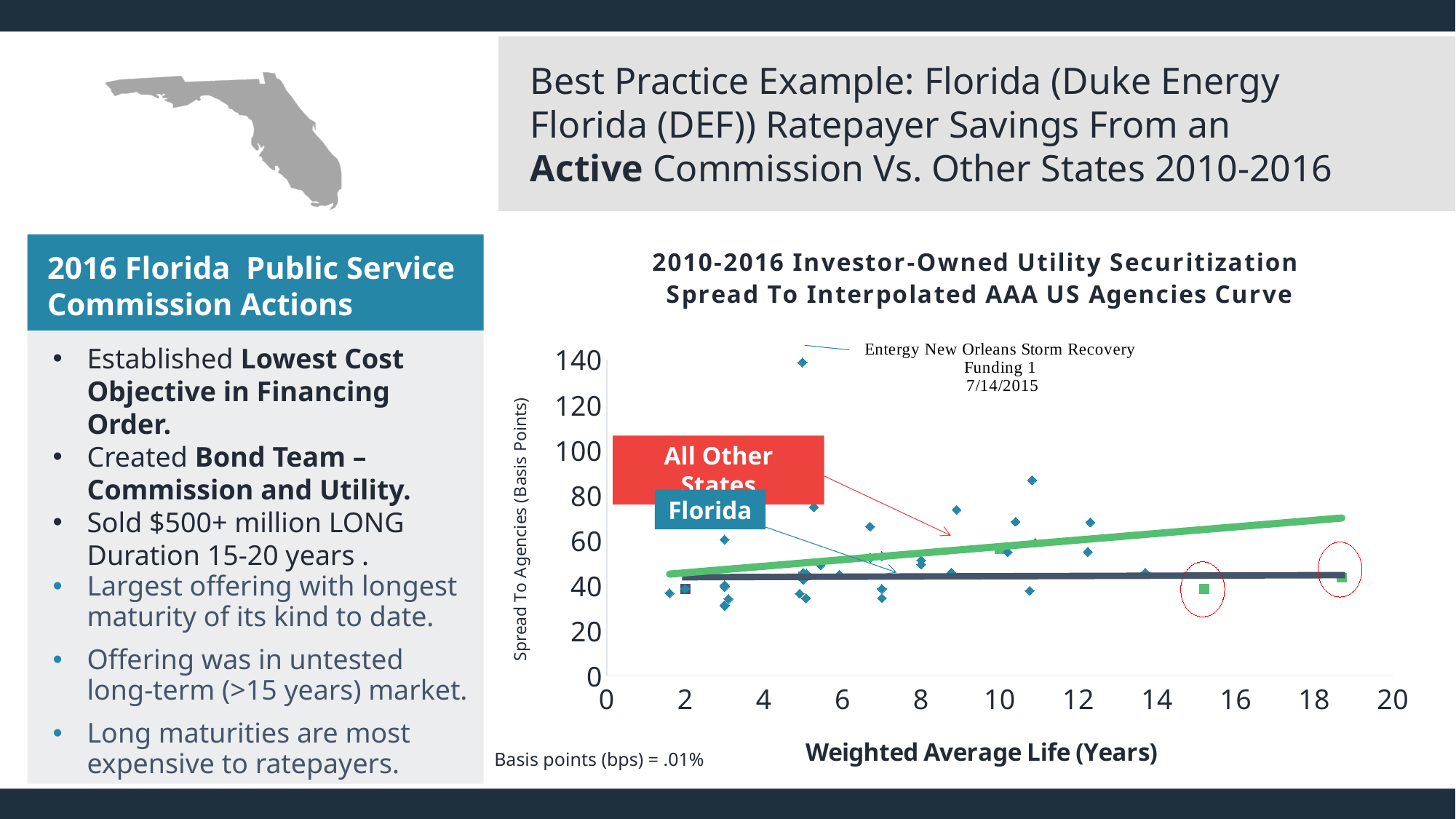
Is the spread for the Entergy New Orleans Storm Recovery Funding 1 point greater or less than 100? greater Is the spread for the Entergy New Orleans Storm Recovery Funding 1 point greater or less than 120? greater Is the spread for the Florida point at about 15 years weighted average life greater or less than 60? less Which labeled data point has the highest spread in the chart? Entergy New Orleans Storm Recovery Funding 1 How many Florida data points are circled in red on the chart? 2 What is the label of the x axis of the chart? Weighted Average Life (Years) What is the highest value shown on the x axis of the chart? 20 What is the title of the chart? 2010-2016 Investor-Owned Utility Securitization Spread To Interpolated AAA US Agencies Curve Does the green trend line for All Other States rise or fall as weighted average life increases? rise What kind of chart is shown on the slide? Scatter chart